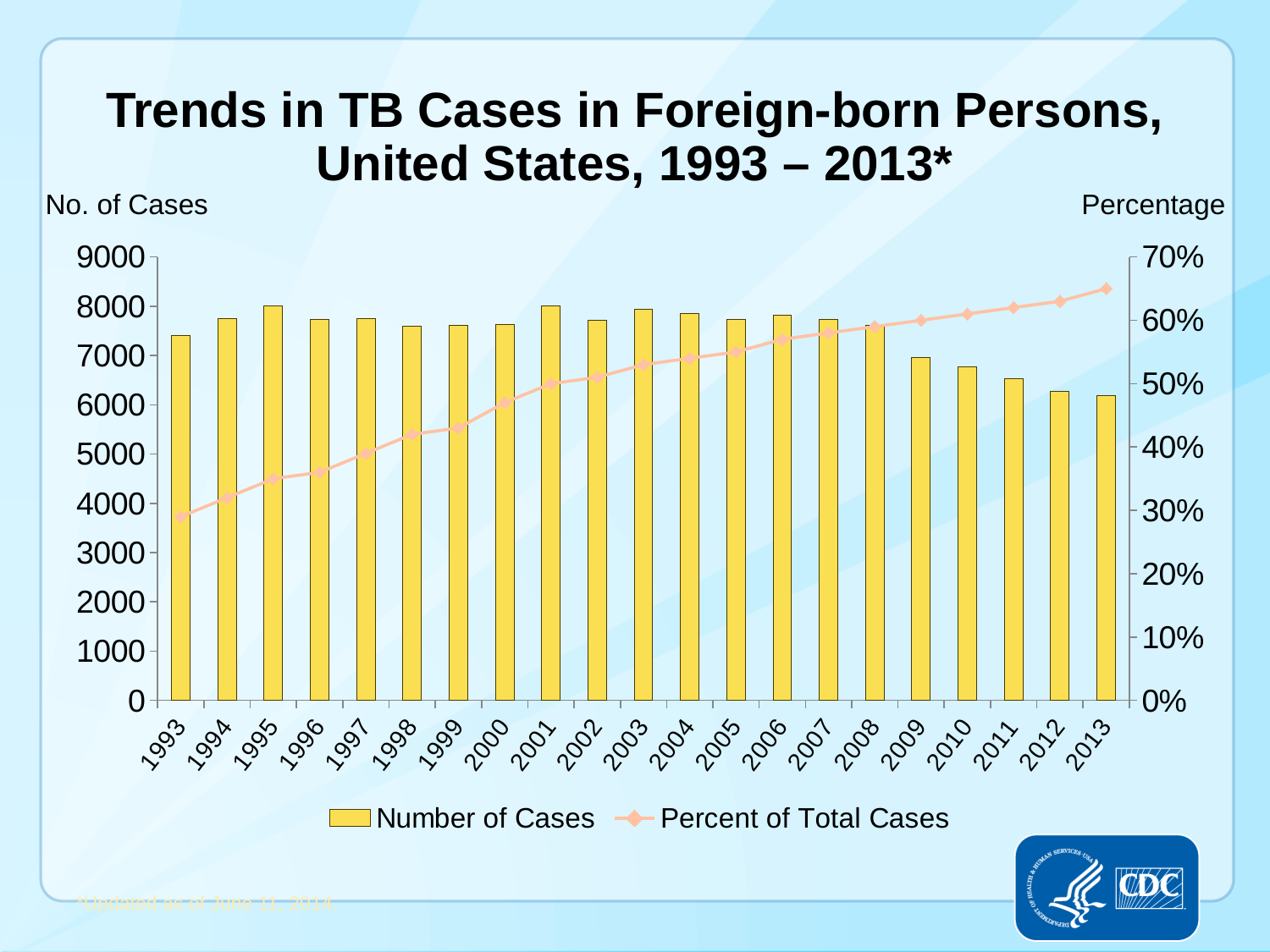
How many years are shown on the x axis? 21 Does the Percent of Total Cases line rise or fall from 1993 to 2013? Rises How many series does the legend list? 2 Is the Percent of Total Cases for 1993 greater or less than 40%? less What is the label of the left vertical axis? No. of Cases What kind of chart is shown on the slide? A combined bar and line chart In which year is the Percent of Total Cases highest? 2013 Is the Number of Cases for 2013 greater or less than 7000? less In which year is the Percent of Total Cases lowest? 1993 Is the Number of Cases for 1995 greater or less than 7000? greater Which year has the larger Number of Cases, 2008 or 2013? 2008